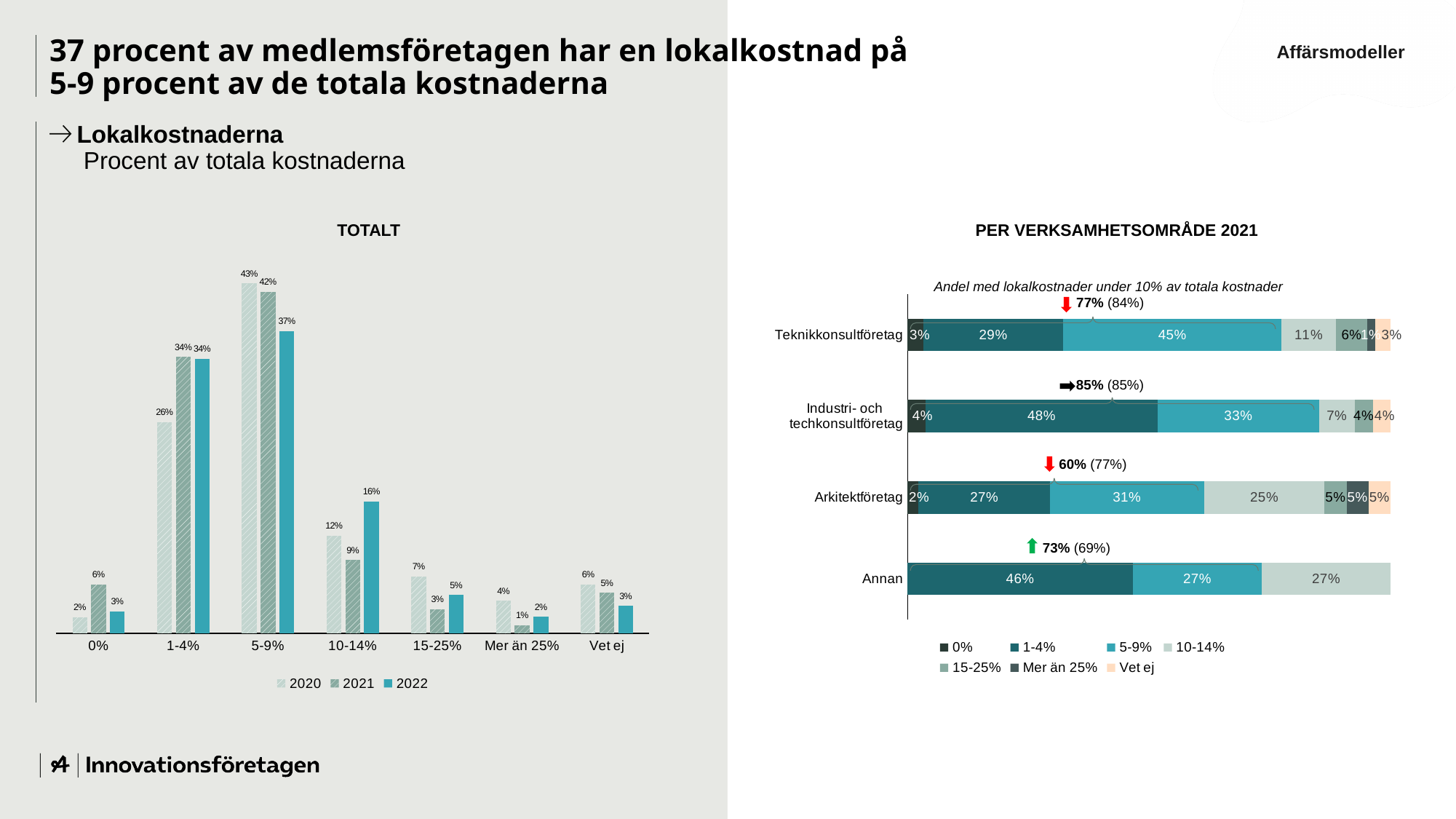
How many categories are shown on the x axis of the TOTALT chart? 7 In the TOTALT chart, which is larger for the 0% category: the 2021 value or the 2022 value? 2021 In the TOTALT chart, which category has the highest 2021 value? 5-9% How many series does the legend of the TOTALT chart list? 3 In the TOTALT chart, what is the difference between the 2022 and 2021 values for the 10-14% category? 7% What kind of chart is the PER VERKSAMHETSOMRÅDE 2021 chart? Stacked bar chart In the TOTALT chart, which category has the lowest 2021 value? Mer än 25% In the PER VERKSAMHETSOMRÅDE 2021 chart, what is the 5-9% value for Teknikkonsultföretag? 45% How many series does the legend of the PER VERKSAMHETSOMRÅDE 2021 chart list? 7 In the TOTALT chart, what is the 2022 value for the 5-9% category? 37% In the PER VERKSAMHETSOMRÅDE 2021 chart, what is the 1-4% value for Annan? 46% In the TOTALT chart, what is the 2020 value for the 1-4% category? 26%